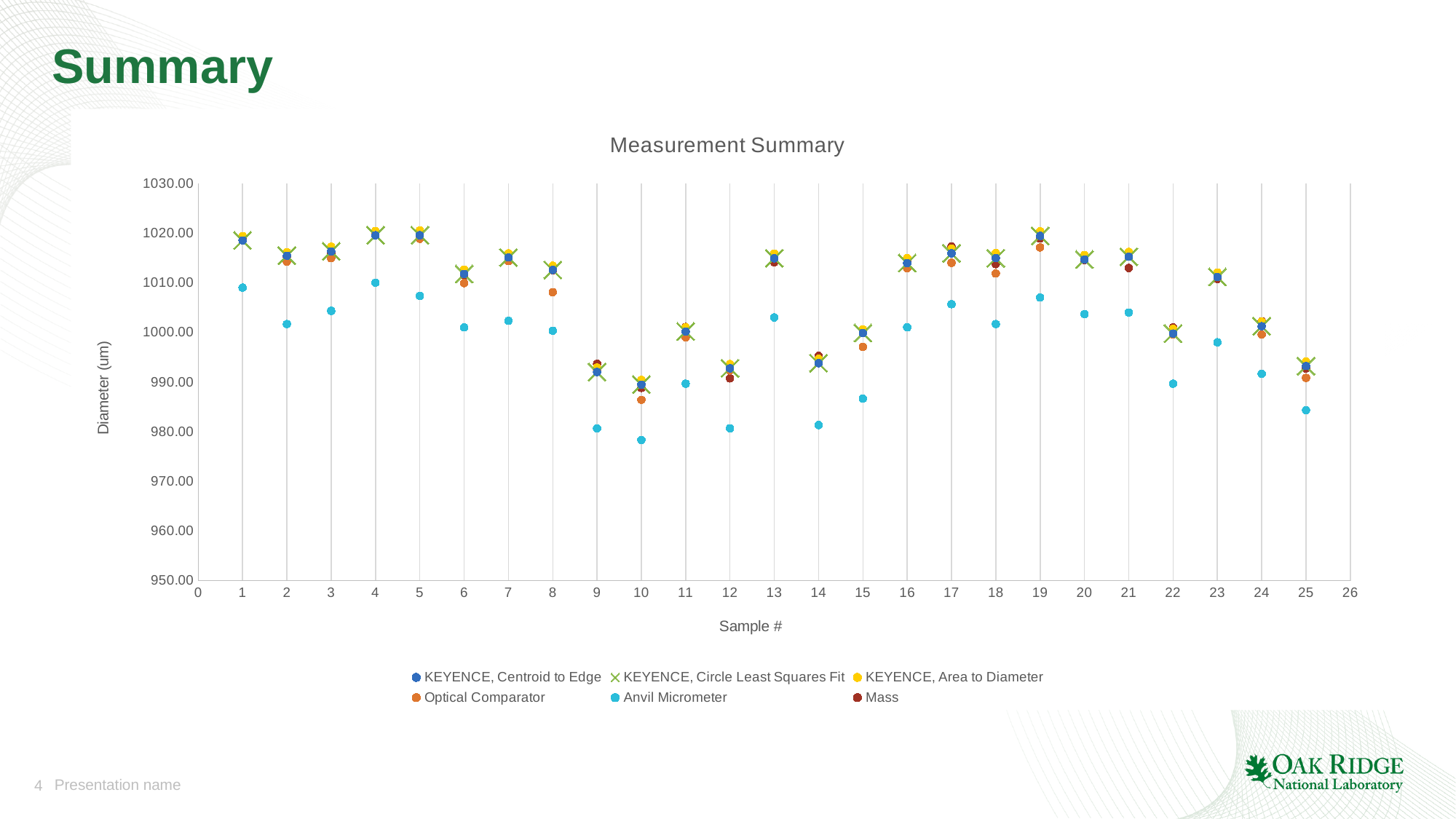
What kind of chart is shown on the slide? scatter chart Is the Anvil Micrometer value for sample 15 greater or less than 990.00? less How many samples are plotted along the x axis? 25 Is the Anvil Micrometer value for sample 25 greater or less than 990.00? less What is the title of the chart? Measurement Summary Is the Optical Comparator value for sample 10 greater or less than 990.00? less For which sample is the Anvil Micrometer value lowest? 10 How many series does the legend list? 6 Which is larger, the Anvil Micrometer value for sample 1 or for sample 2? sample 1 Do the Anvil Micrometer values rise or fall from sample 5 to sample 10? fall What is the label of the y axis? Diameter (um)